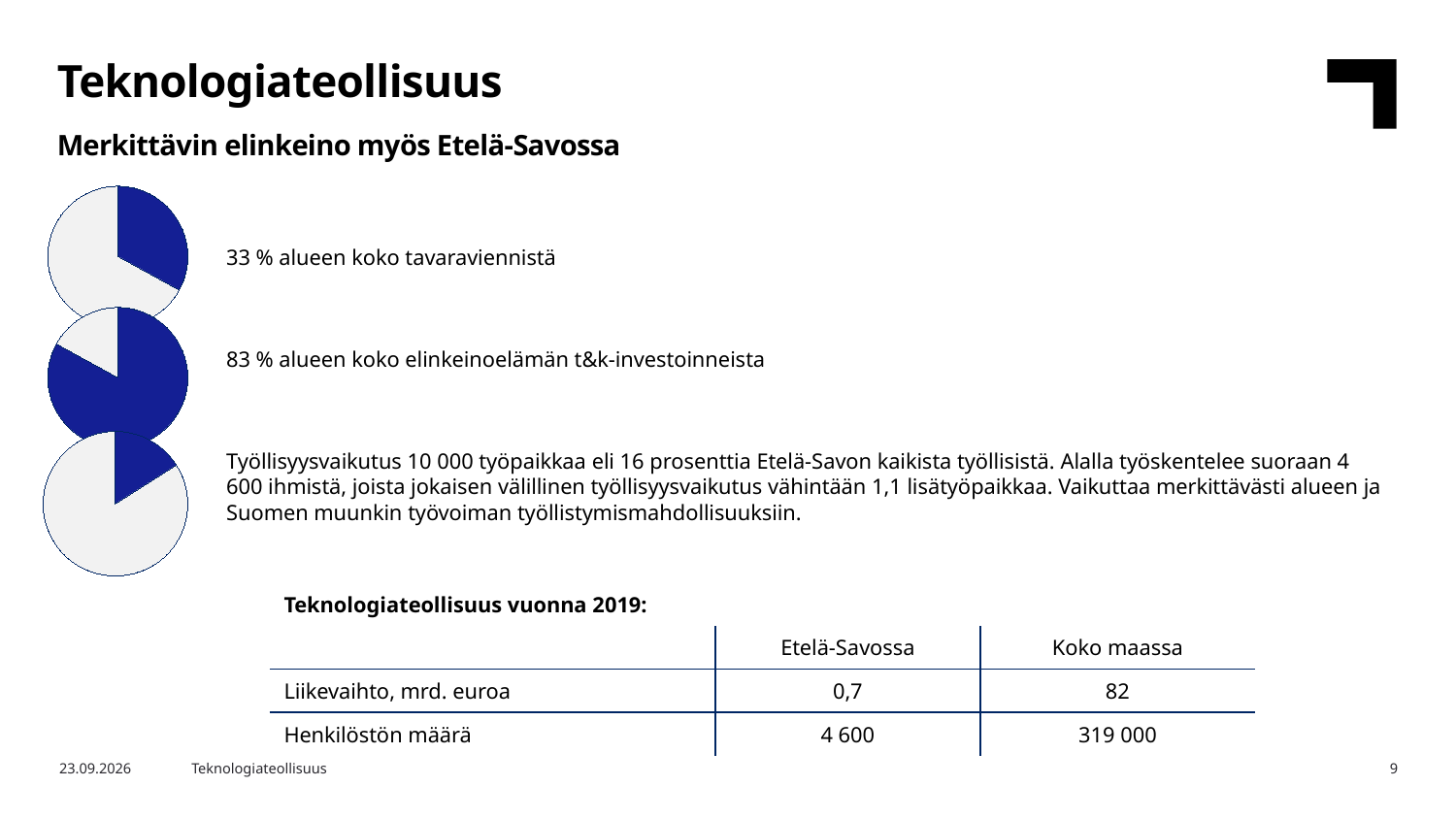
According to the text next to the top pie chart, what share of the region's total goods exports does the technology industry represent? 33 % Is the blue slice in the top pie chart larger or smaller than the blue slice in the middle pie chart? smaller How many pie charts are on the slide? 3 Is the blue slice in the middle pie chart greater or less than 50% of the pie? greater What colour is the highlighted slice in each pie chart? blue According to the text next to the bottom pie chart, what percentage of all employed people in Etelä-Savo does the technology industry account for? 16 prosenttia What kind of chart is shown on the left side of the slide? pie chart Is the blue slice in the bottom pie chart greater or less than 50% of the pie? less Which of the three pie charts has the smallest blue slice? the bottom pie chart Which of the three pie charts has the largest blue slice? the middle pie chart How many slices does each pie chart have? 2 According to the text next to the middle pie chart, what share of the region's business R&D investments does the technology industry represent? 83 %